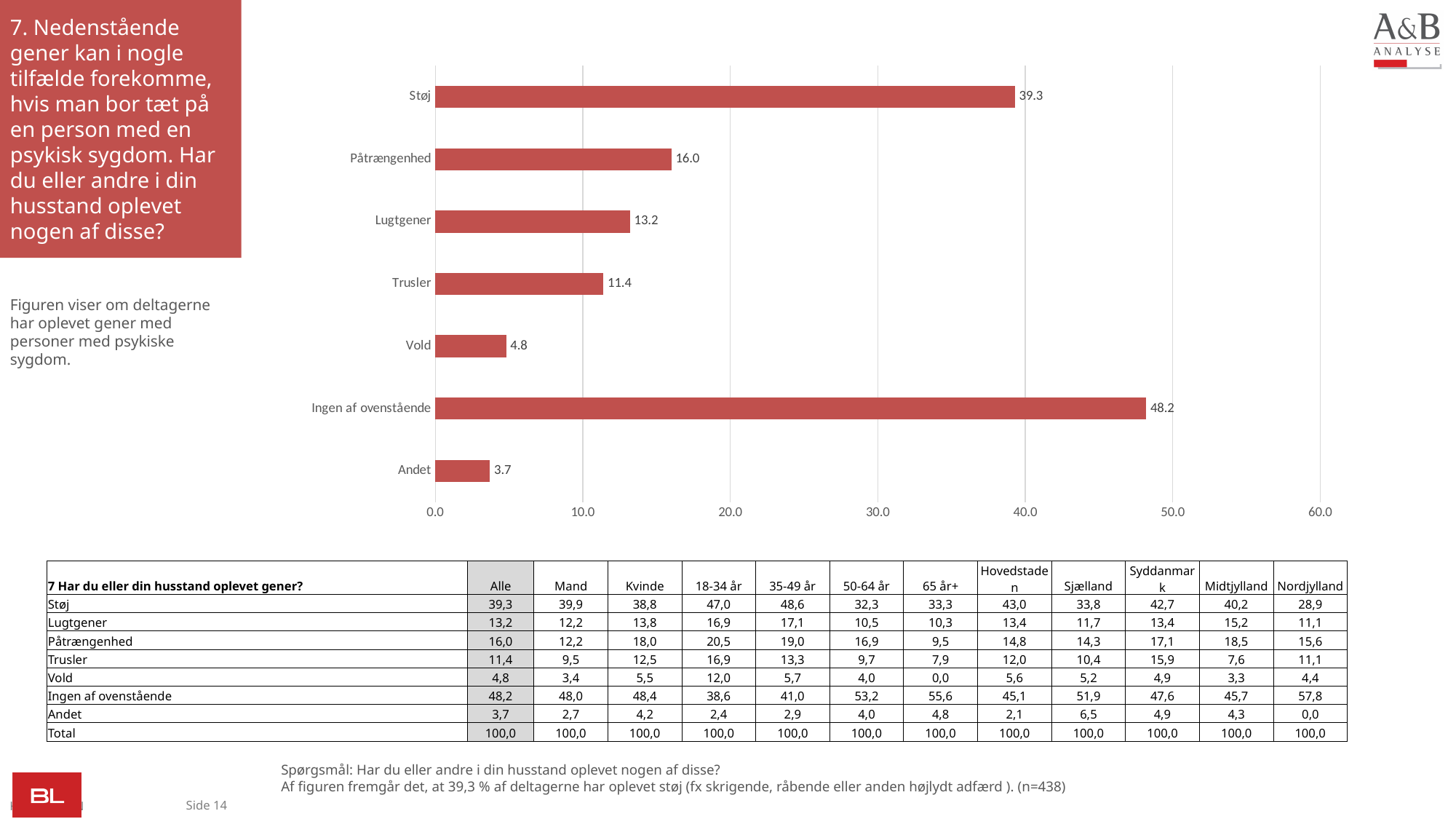
What is the value for Påtrængenhed? 16.0 Which is larger, the value for Trusler or the value for Vold? Trusler Which category has the lowest value? Andet What is the value for Vold? 4.8 Which category has the highest value? Ingen af ovenstående What is the difference between the values for Påtrængenhed and Lugtgener? 2.8 How many categories are shown in the chart? 7 What kind of chart is shown on the slide? Bar chart What is the value for Ingen af ovenstående? 48.2 What is the value for Støj? 39.3 Is the value for Lugtgener greater or less than 10.0? greater What is the difference between the values for Ingen af ovenstående and Støj? 8.9